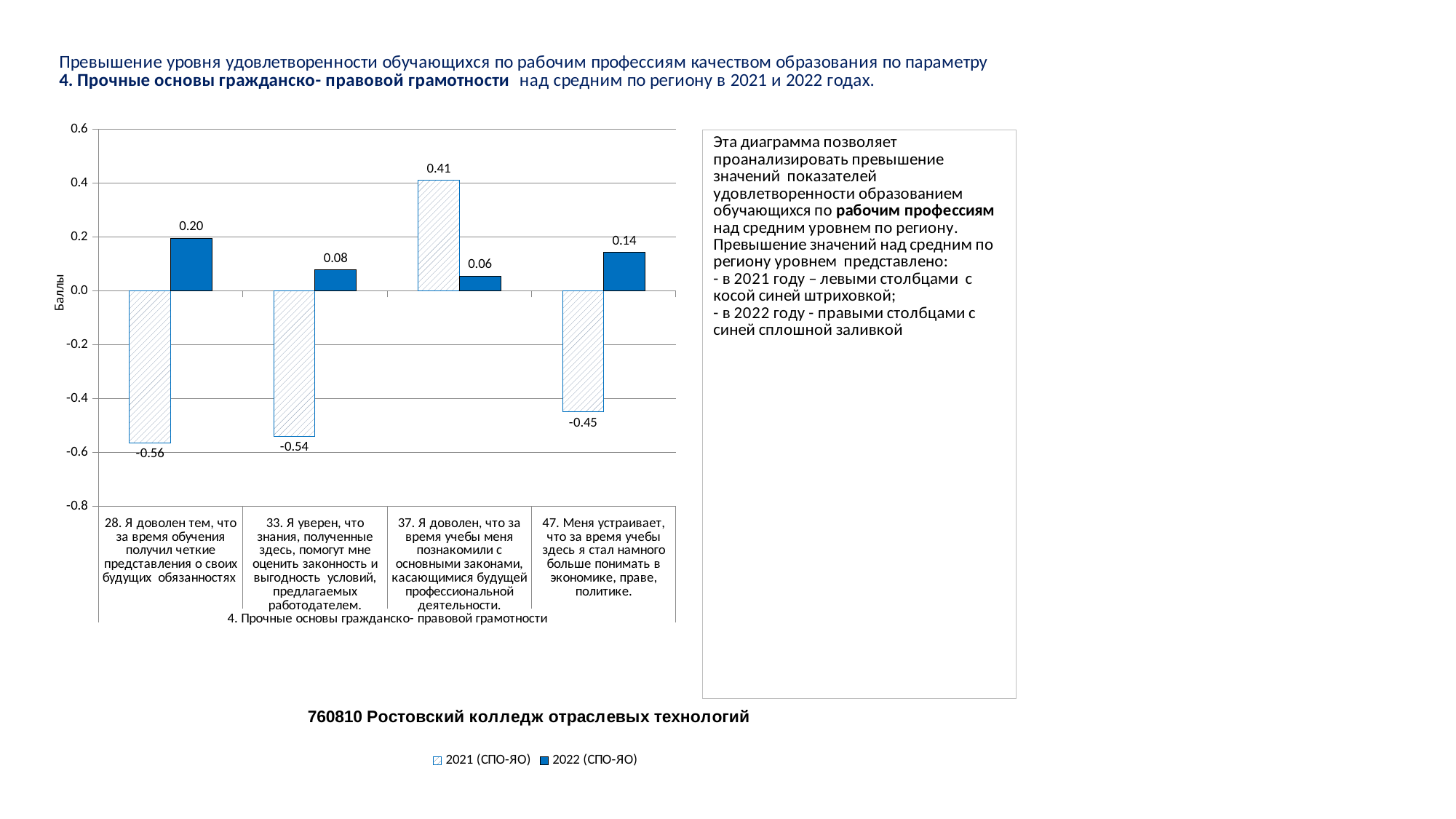
How many categories are shown on the x axis of the chart? 4 How many series does the legend list? 2 Which category has the highest 2022 (СПО-ЯО) value? 28. Я доволен тем, что за время обучения получил четкие представления о своих будущих обязанностях What is the label of the vertical axis of the chart? Баллы What is the 2021 (СПО-ЯО) value for category 28 (Я доволен тем, что за время обучения получил четкие представления о своих будущих обязанностях)? -0.56 What is the difference between the 2022 (СПО-ЯО) and 2021 (СПО-ЯО) values for category 33? 0.62 For category 37, which series has the larger value, 2021 (СПО-ЯО) or 2022 (СПО-ЯО)? 2021 (СПО-ЯО) Which category has the lowest 2021 (СПО-ЯО) value? 28. Я доволен тем, что за время обучения получил четкие представления о своих будущих обязанностях What kind of chart is shown on the slide? Bar chart Is the 2021 (СПО-ЯО) value for category 47 greater or less than -0.4? less What is the 2022 (СПО-ЯО) value for category 37 (Я доволен, что за время учебы меня познакомили с основными законами)? 0.06 What is the 2022 (СПО-ЯО) value for category 47 (Меня устраивает, что за время учебы здесь я стал намного больше понимать в экономике, праве, политике)? 0.14